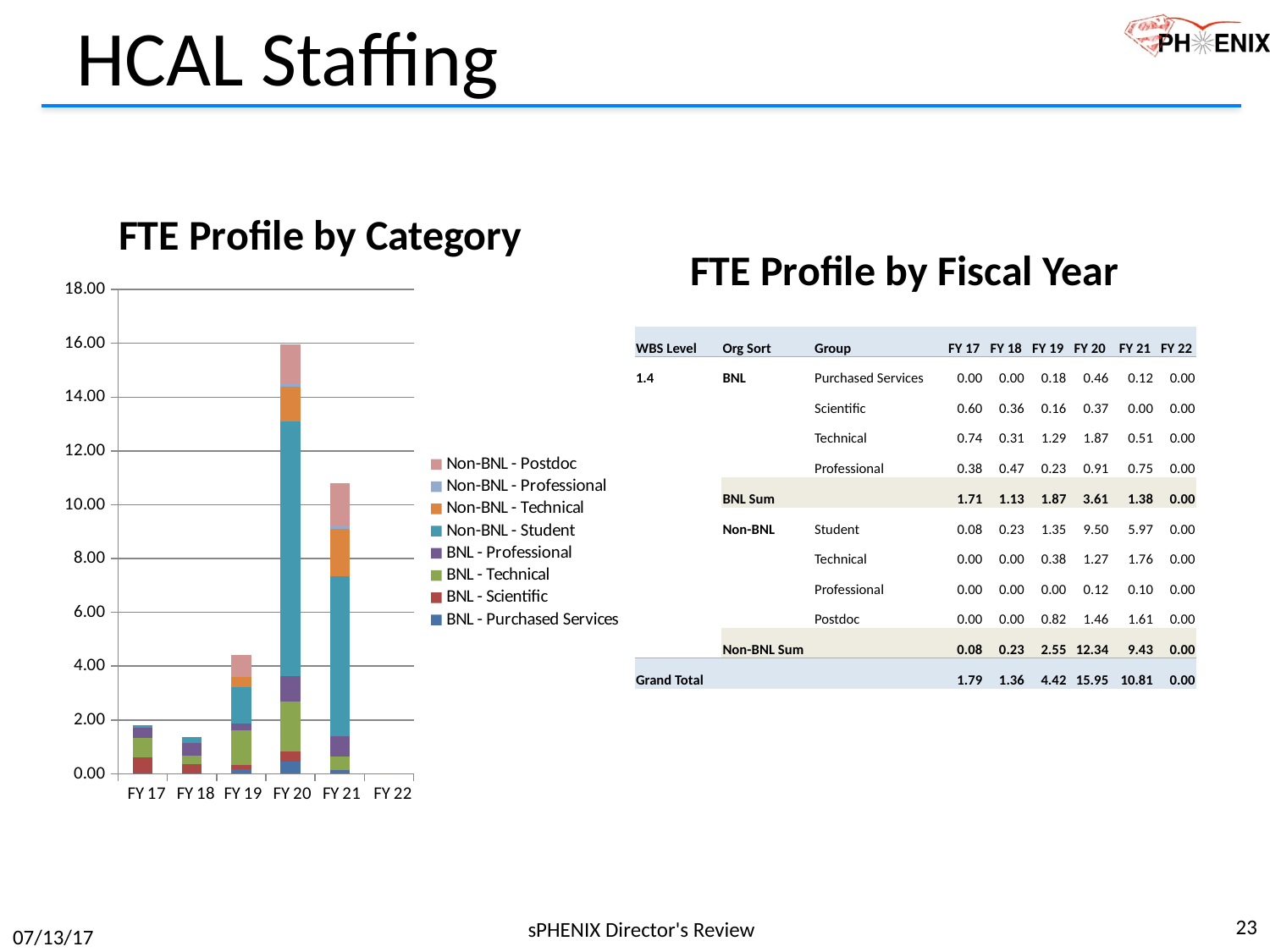
How many fiscal-year categories are shown on the x axis of the FTE Profile by Category chart? 6 In the FTE Profile by Category chart, do the stacked bar totals rise or fall from FY 20 to FY 22? fall In the FTE Profile by Category chart, which stacked bar is taller, FY 20 or FY 21? FY 20 How many series does the legend of the FTE Profile by Category chart list? 8 What kind of chart is shown under the title "FTE Profile by Category"? stacked bar chart In the FTE Profile by Category chart, is the total stacked bar for FY 20 greater or less than 14.00? greater Which fiscal year has the tallest stacked bar in the FTE Profile by Category chart? FY 20 In the FTE Profile by Category chart, is the total stacked bar for FY 21 greater or less than 8.00? greater Which fiscal year has the lowest total in the FTE Profile by Category chart? FY 22 Which series is listed first (at the top) in the legend of the FTE Profile by Category chart? Non-BNL - Postdoc In the FTE Profile by Category chart, which stacked bar is taller, FY 18 or FY 19? FY 19 In the FTE Profile by Category chart, is the total stacked bar for FY 19 greater or less than 6.00? less